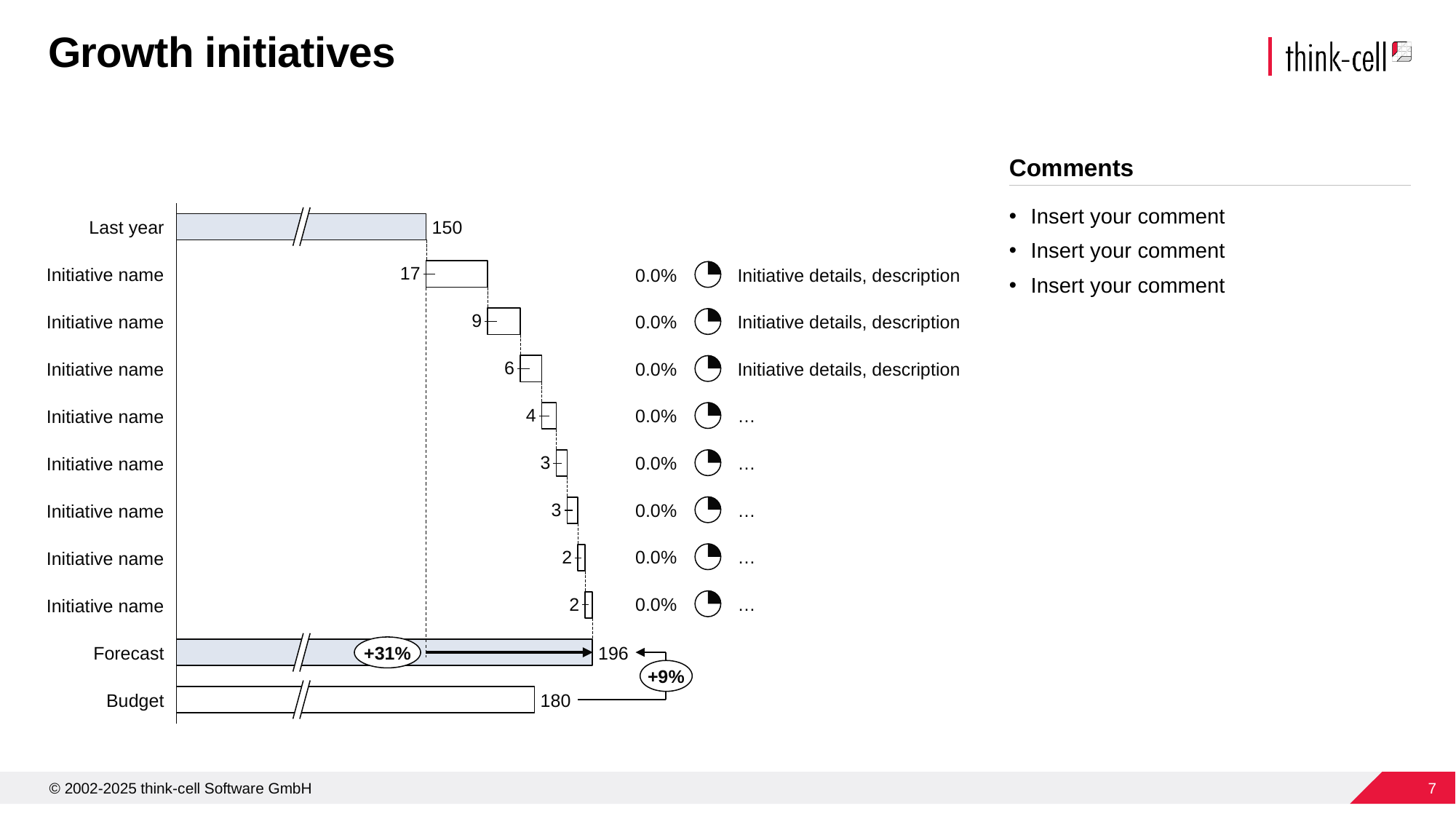
What is the value shown for Forecast? 196 What is the difference between the Forecast value and the Last year value? 46 How many 'Initiative name' rows are plotted between Last year and Forecast? 8 What is the value shown for Budget? 180 What is the value of the largest single initiative bar? 17 Which is larger, the Forecast value or the Budget value? Forecast What is the difference between the Forecast value and the Budget value? 16 What kind of chart is shown on the slide? Waterfall bar chart What percentage growth is labelled between Last year and Forecast? +31% What is the value shown for Last year? 150 What percentage is labelled between Budget and Forecast? +9% What is the value of the smallest initiative bar? 2